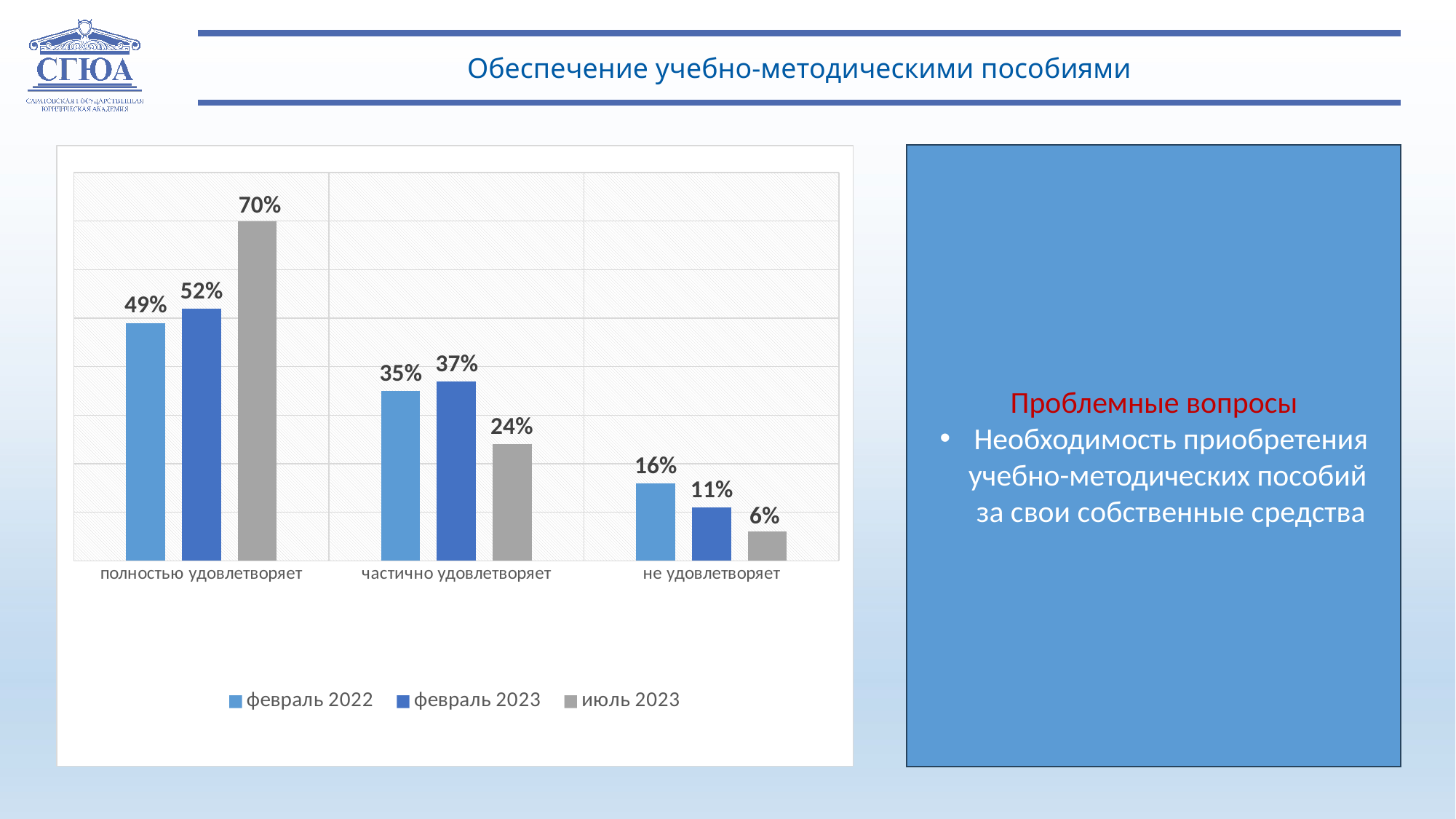
What is the value for 'частично удовлетворяет' in the 'февраль 2022' series? 35% How many series does the legend list? 3 What is the difference between the 'февраль 2023' and 'июль 2023' values for 'частично удовлетворяет'? 13% Which is larger for 'не удовлетворяет': the 'февраль 2022' value or the 'июль 2023' value? февраль 2022 How many categories are shown on the x axis? 3 Does the 'июль 2023' series rise or fall across the categories from left to right? fall What is the value for 'не удовлетворяет' in the 'февраль 2023' series? 11% Which category has the lowest value in the 'февраль 2022' series? не удовлетворяет What is the difference between the 'июль 2023' and 'февраль 2022' values for 'полностью удовлетворяет'? 21% What kind of chart is shown on the slide? bar chart Which category has the highest value in the 'июль 2023' series? полностью удовлетворяет What is the value for 'полностью удовлетворяет' in the 'июль 2023' series? 70%